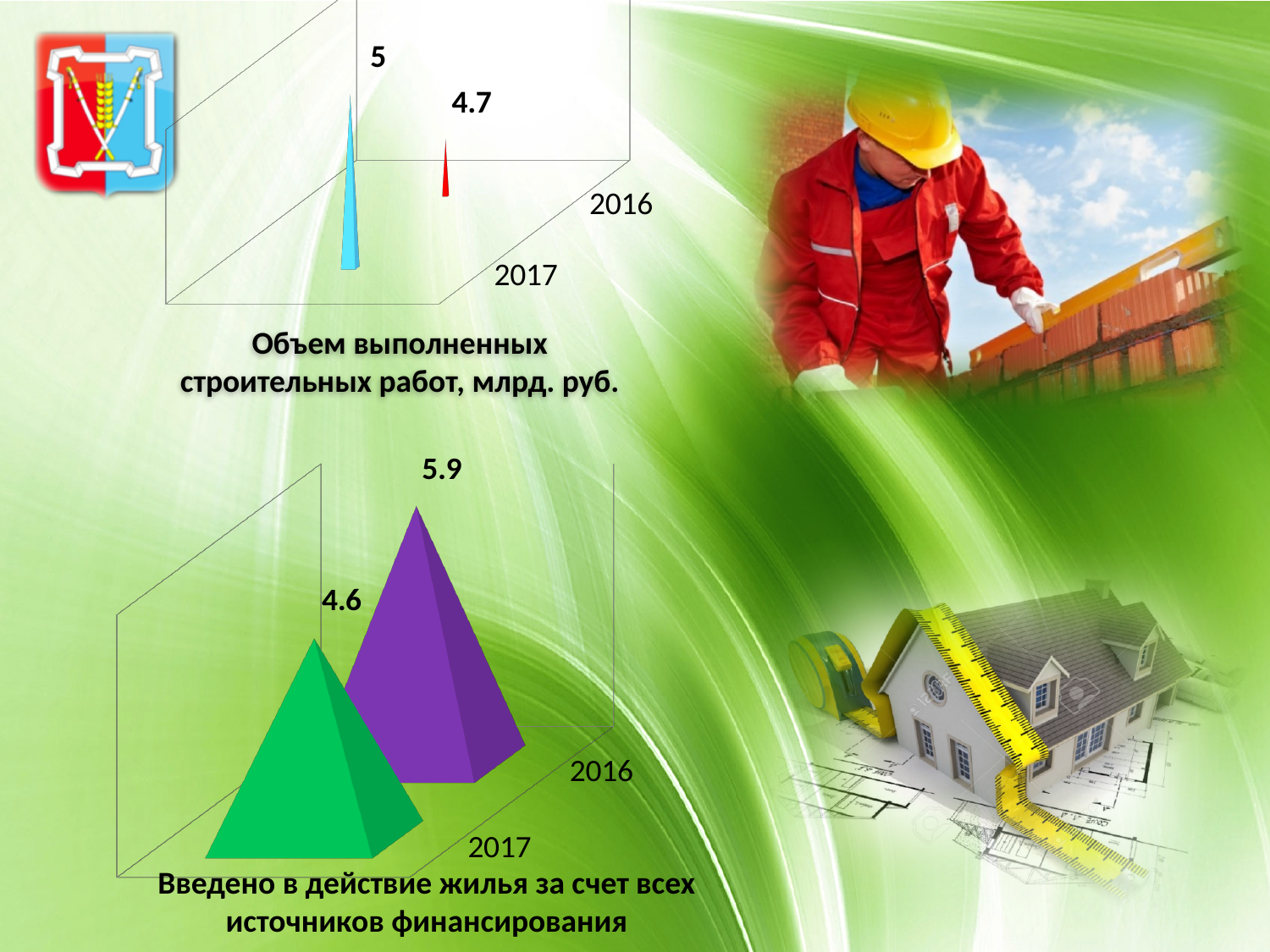
In the chart titled 'Введено в действие жилья за счет всех источников финансирования', what is the difference between the 2016 and 2017 values? 1.3 In the chart titled 'Объем выполненных строительных работ, млрд. руб.', what is the value for 2016? 4.7 In the chart titled 'Введено в действие жилья за счет всех источников финансирования', which year has the lower value? 2017 What kind of chart is the bottom chart on the slide? bar chart In the chart titled 'Введено в действие жилья за счет всех источников финансирования', what is the value for 2017? 4.6 In the bottom chart, what colour is the bar for 2016? purple In the chart titled 'Объем выполненных строительных работ, млрд. руб.', which year has the higher value? 2017 In the chart titled 'Введено в действие жилья за счет всех источников финансирования', did the value rise or fall from 2016 to 2017? fall In the chart titled 'Объем выполненных строительных работ, млрд. руб.', how many years are shown? 2 In the chart titled 'Объем выполненных строительных работ, млрд. руб.', what is the difference between the 2017 and 2016 values? 0.3 In the chart titled 'Введено в действие жилья за счет всех источников финансирования', what is the value for 2016? 5.9 In the chart titled 'Объем выполненных строительных работ, млрд. руб.', what is the value for 2017? 5